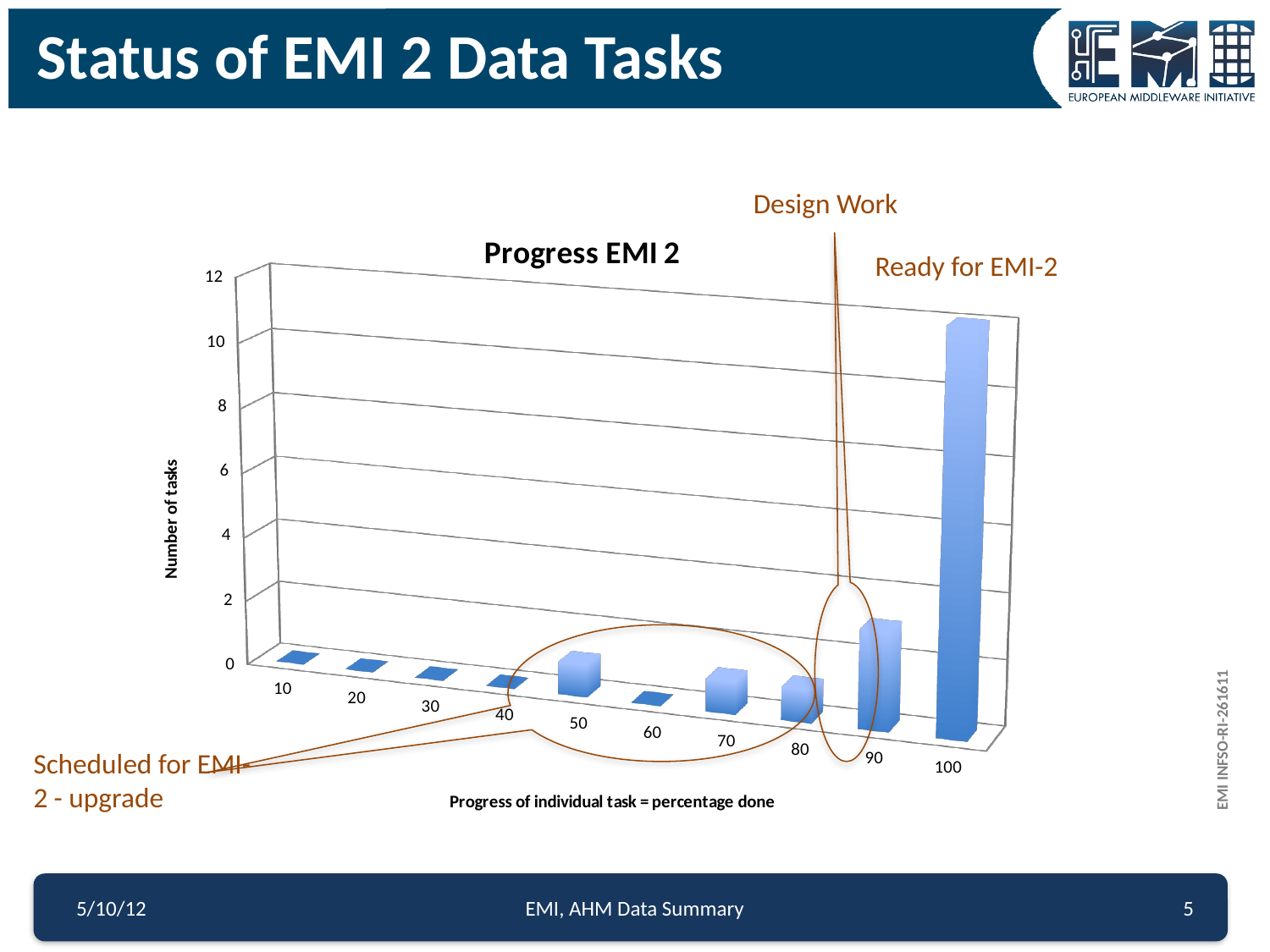
How many categories are shown on the x axis of the chart? 10 Is the value for 90 greater or less than 6? less Which has more tasks, 50 or 90? 90 Which category has the highest number of tasks? 100 Is the value for 100 greater or less than 8? greater What is the title of the chart? Progress EMI 2 What kind of chart is shown on the slide? bar chart What is the label of the vertical axis? Number of tasks Is the value for 50 greater or less than 4? less Which has more tasks, 90 or 100? 100